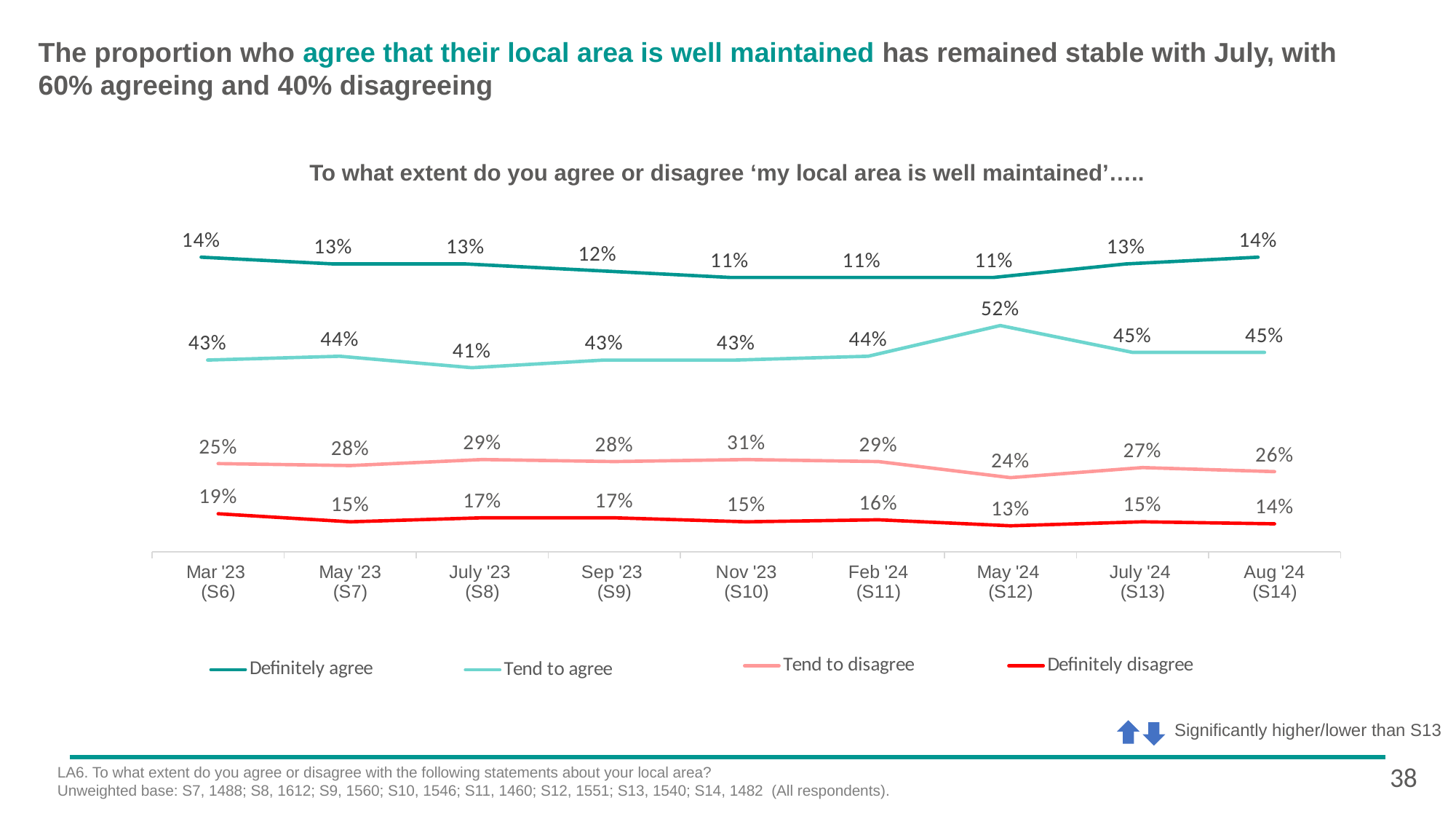
What is the value for Tend to disagree in Nov '23 (S10)? 31% What kind of chart is shown on the slide? Line chart What is the value for Definitely agree in Aug '24 (S14)? 14% What is the value for Definitely disagree in Mar '23 (S6)? 19% How many series does the legend list? 4 Which series is drawn in the bright red line? Definitely disagree In which period is the Tend to agree series highest? May '24 (S12) Which is larger in July '23 (S8): Tend to disagree or Definitely disagree? Tend to disagree How many time periods are shown on the x axis? 9 What is the value for Tend to agree in May '24 (S12)? 52% In which period is the Tend to disagree series lowest? May '24 (S12) What is the difference between Tend to agree and Tend to disagree in Aug '24 (S14)? 19 percentage points